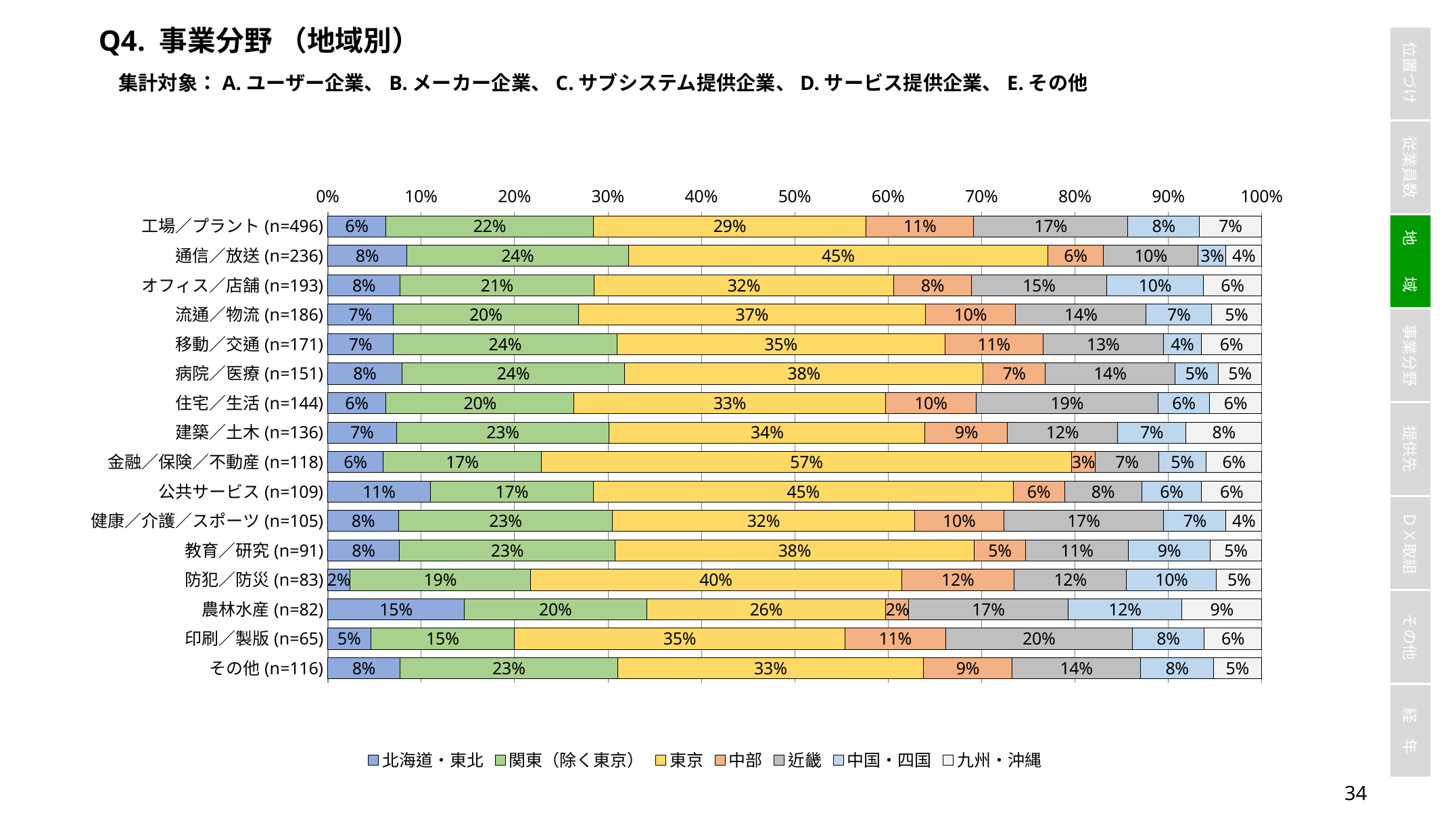
What is the value for 近畿 in the 印刷／製版 (n=65) bar? 20% Which colour represents 東京 in the chart? Yellow How many series does the legend list? 7 Which is larger: the 関東（除く東京） value for 通信／放送 (n=236) or for 工場／プラント (n=496)? 通信／放送 (n=236) What is the value for 東京 in the 金融／保険／不動産 (n=118) bar? 57% What is the value for 中部 in the 農林水産 (n=82) bar? 2% Which category has the highest value for 東京? 金融／保険／不動産 (n=118) What kind of chart is shown on the slide? Stacked bar chart Which category has the lowest value for 北海道・東北? 防犯／防災 (n=83) How many categories (business fields) are shown on the chart? 16 What is the value for 北海道・東北 in the 農林水産 (n=82) bar? 15% In the 工場／プラント (n=496) bar, what is the difference between the 東京 value and the 近畿 value? 12 percentage points